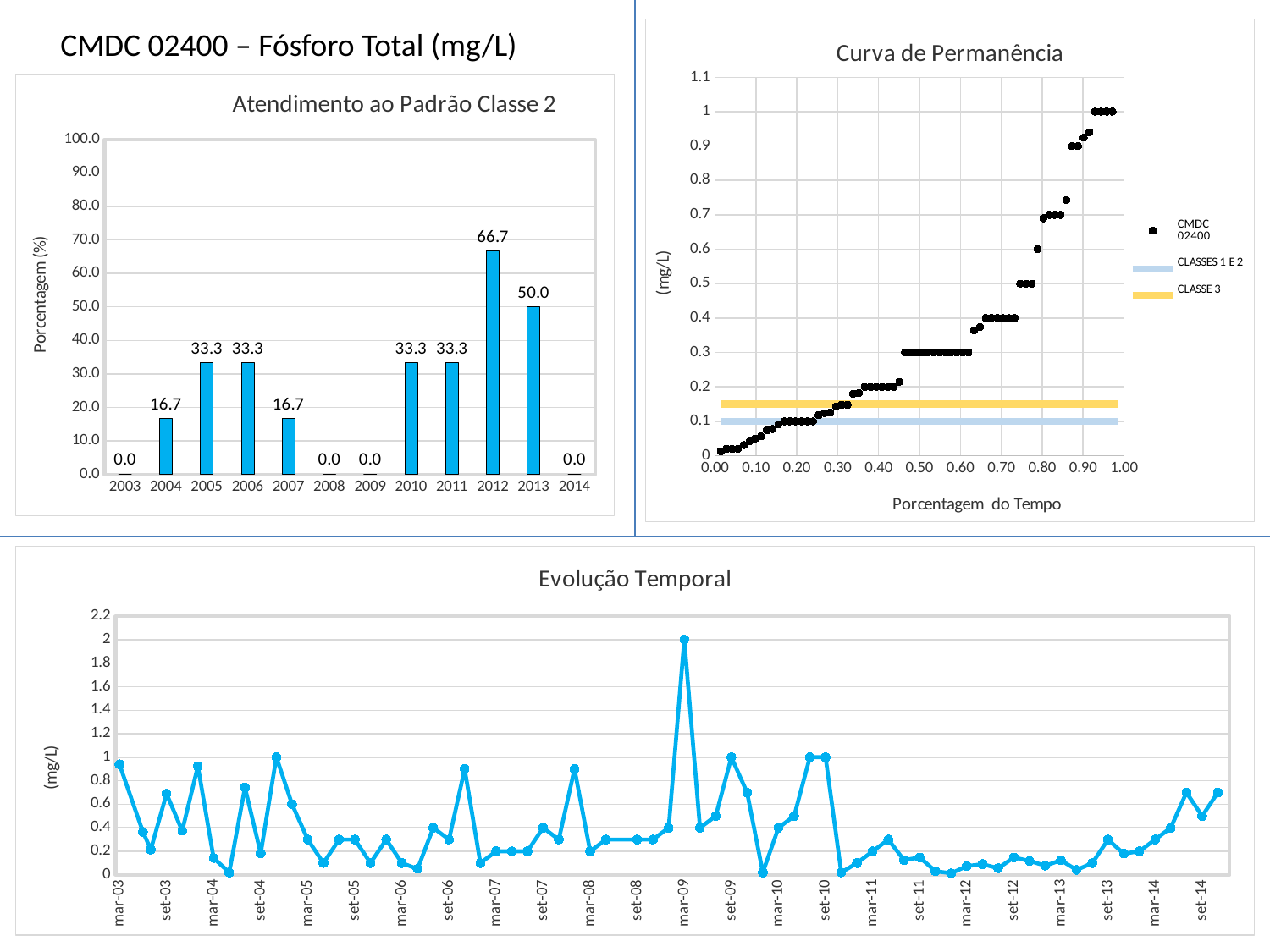
What kind of chart is 'Atendimento ao Padrão Classe 2'? bar chart In the 'Atendimento ao Padrão Classe 2' chart, what is the value for 2012? 66.7 In the 'Atendimento ao Padrão Classe 2' chart, which is larger, the value for 2004 or the value for 2005? 2005 In the 'Atendimento ao Padrão Classe 2' chart, which year has the highest value? 2012 In the 'Curva de Permanência' chart, do the plotted values rise or fall as the percentage of time increases along the x axis? rise In the 'Evolução Temporal' chart, is the value at mar-09 greater or less than 1.8? greater In the 'Atendimento ao Padrão Classe 2' chart, how many years have a value of 0.0? 4 What is the x-axis title of the 'Curva de Permanência' chart? Porcentagem do Tempo In the 'Atendimento ao Padrão Classe 2' chart, what is the value for 2013? 50.0 How many years are shown on the x axis of the 'Atendimento ao Padrão Classe 2' chart? 12 In the 'Atendimento ao Padrão Classe 2' chart, what is the difference between the values for 2012 and 2013? 16.7 How many series does the legend of the 'Curva de Permanência' chart list? 3